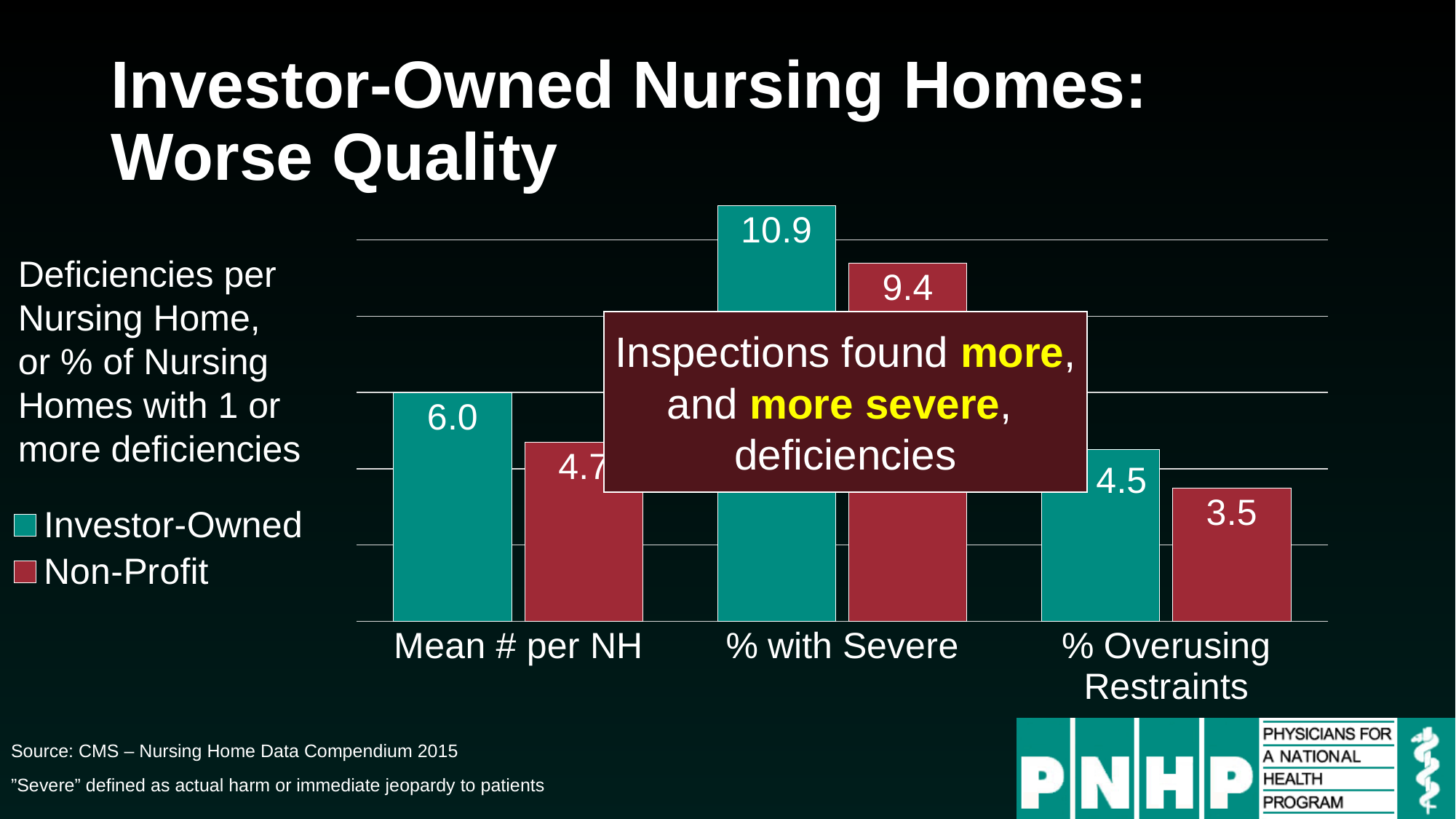
What is the Non-Profit value for % with Severe? 9.4 How many series does the legend list? 2 What is the Non-Profit value for % Overusing Restraints? 3.5 For % with Severe, which series has the larger value, Investor-Owned or Non-Profit? Investor-Owned What is the Investor-Owned value for % Overusing Restraints? 4.5 What is the Investor-Owned value for % with Severe? 10.9 Which category has the highest Investor-Owned value? % with Severe Which category has the lowest Non-Profit value? % Overusing Restraints What is the Investor-Owned value for Mean # per NH? 6.0 What is the difference between the Investor-Owned and Non-Profit values for % Overusing Restraints? 1.0 How many categories are shown on the x axis of the chart? 3 What is the difference between the Investor-Owned and Non-Profit values for % with Severe? 1.5